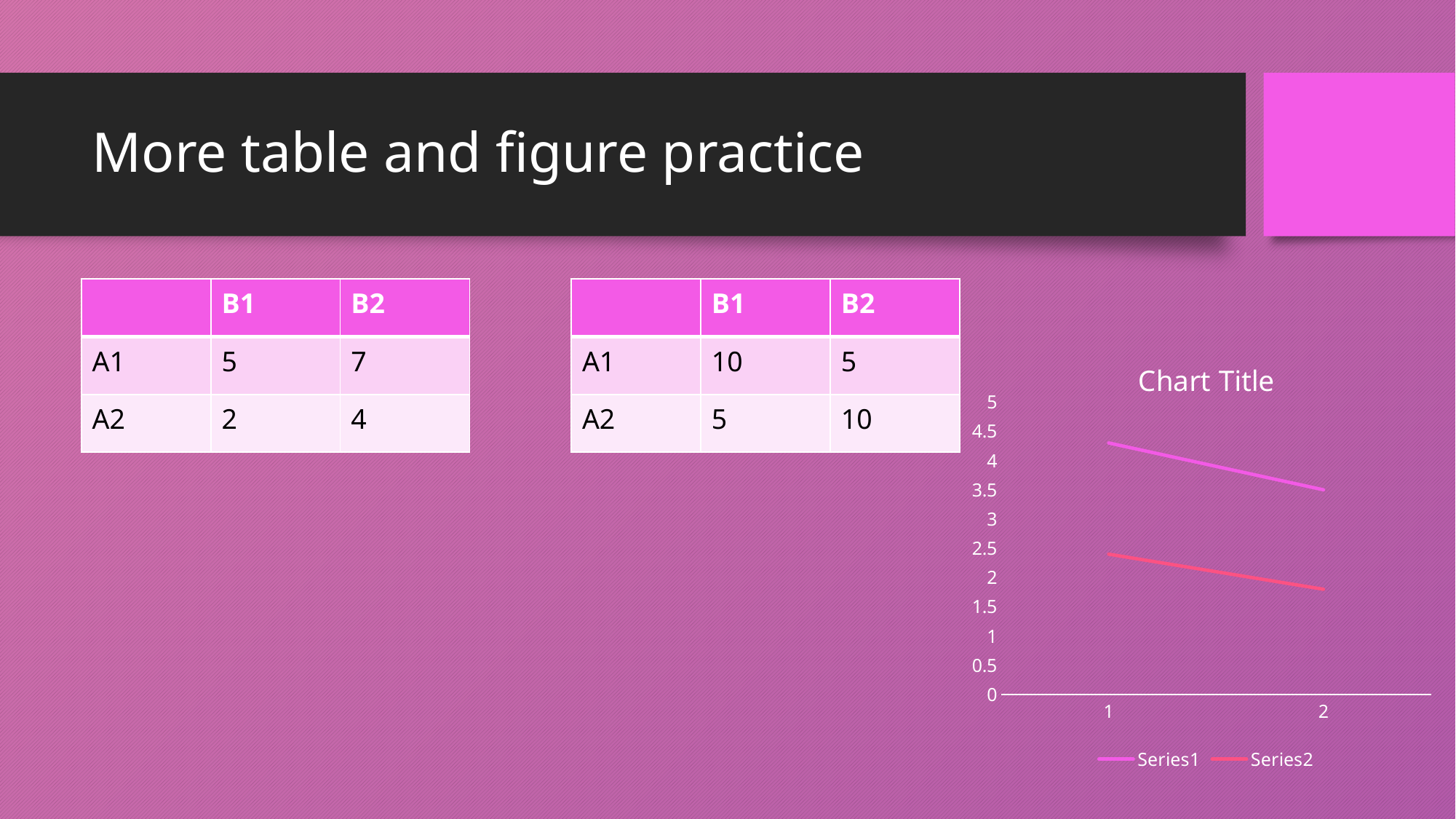
Does Series2 rise or fall from x = 1 to x = 2? fall How many points are plotted along the x axis of the chart? 2 Does Series1 rise or fall from x = 1 to x = 2? fall Is the value for Series2 at x = 1 greater or less than 2? greater How many series does the chart's legend list? 2 At x = 2, which series has the larger value, Series1 or Series2? Series1 Is the value for Series1 at x = 1 greater or less than 4? greater What are the names of the series listed in the chart's legend? Series1 and Series2 Is the value for Series1 at x = 2 greater or less than 4? less At x = 1, which series has the larger value, Series1 or Series2? Series1 What kind of chart is shown on the slide? line chart What is the title of the chart? Chart Title